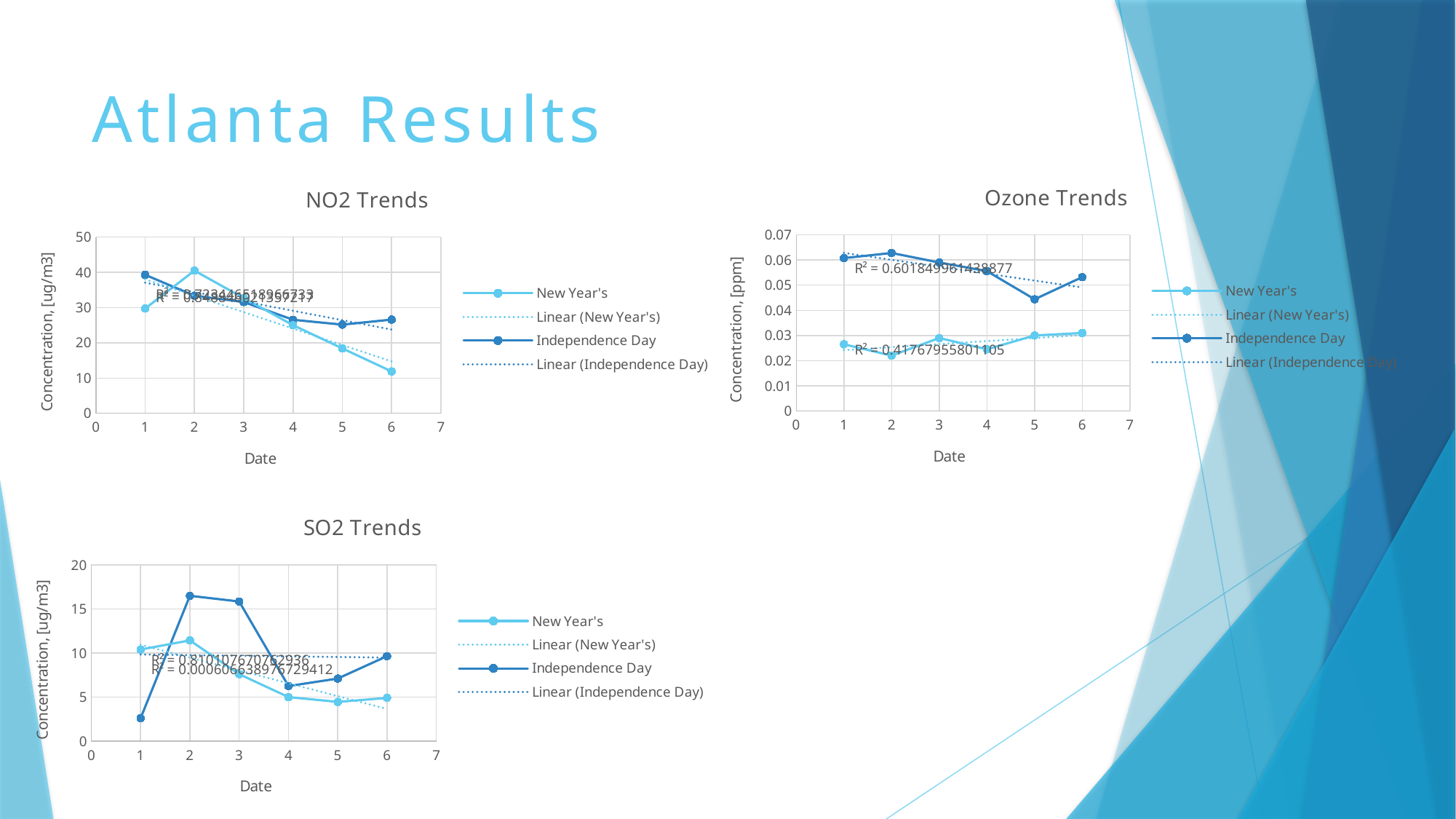
How many entries does the legend of the Ozone Trends chart list? 4 In the Ozone Trends chart, at which date is the Independence Day value lowest? 5 In the Ozone Trends chart, which series has the larger value at date 3, New Year's or Independence Day? Independence Day What is the y-axis label of the Ozone Trends chart? Concentration, [ppm] In the Ozone Trends chart, is the Independence Day value at date 2 greater or less than 0.06? greater In the SO2 Trends chart, how many data points does the Independence Day series have? 6 What kind of chart is the NO2 Trends chart? line chart In the NO2 Trends chart, which series has the larger value at date 6, New Year's or Independence Day? Independence Day In the SO2 Trends chart, at which date is the Independence Day value highest? 2 In the NO2 Trends chart, is the New Year's value at date 6 greater or less than 20? less In the NO2 Trends chart, at which date is the New Year's value highest? 2 In the SO2 Trends chart, is the Independence Day value at date 1 greater or less than 5? less